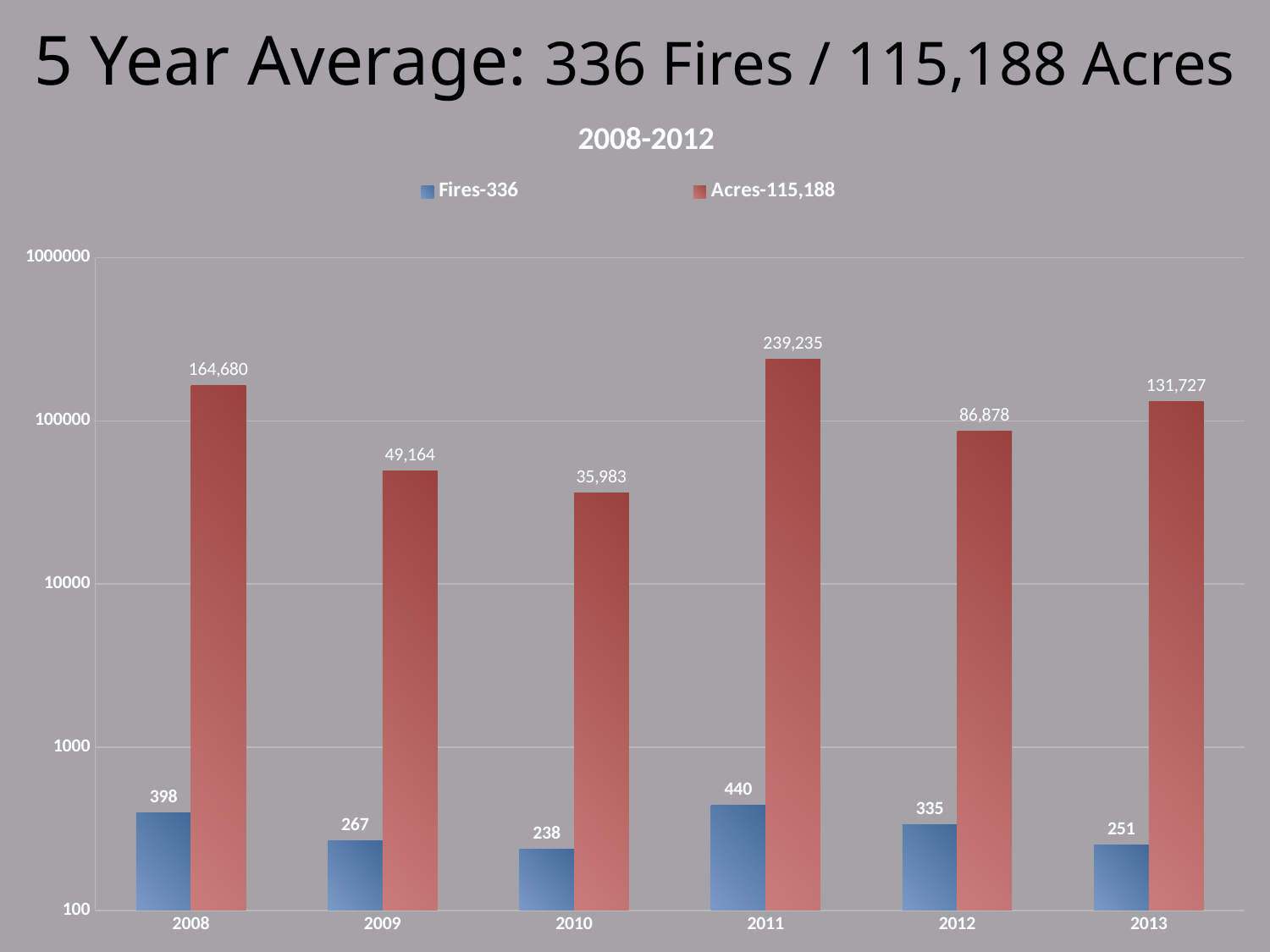
Is the value for Acres-115,188 in 2010 greater or less than 100000? less What is the value for Fires-336 in 2011? 440 Which is larger, the Fires-336 value for 2009 or for 2012? 2012 What is the value for Acres-115,188 in 2009? 49,164 What is the title of the chart? 2008-2012 What kind of chart is shown on the slide? bar chart How many series does the legend list? 2 Which year has the highest value for Acres-115,188? 2011 Which year has the lowest value for Fires-336? 2010 How many years are shown on the x axis? 6 What is the value for Fires-336 in 2013? 251 What is the difference between the Acres-115,188 values for 2008 and 2013? 32,953